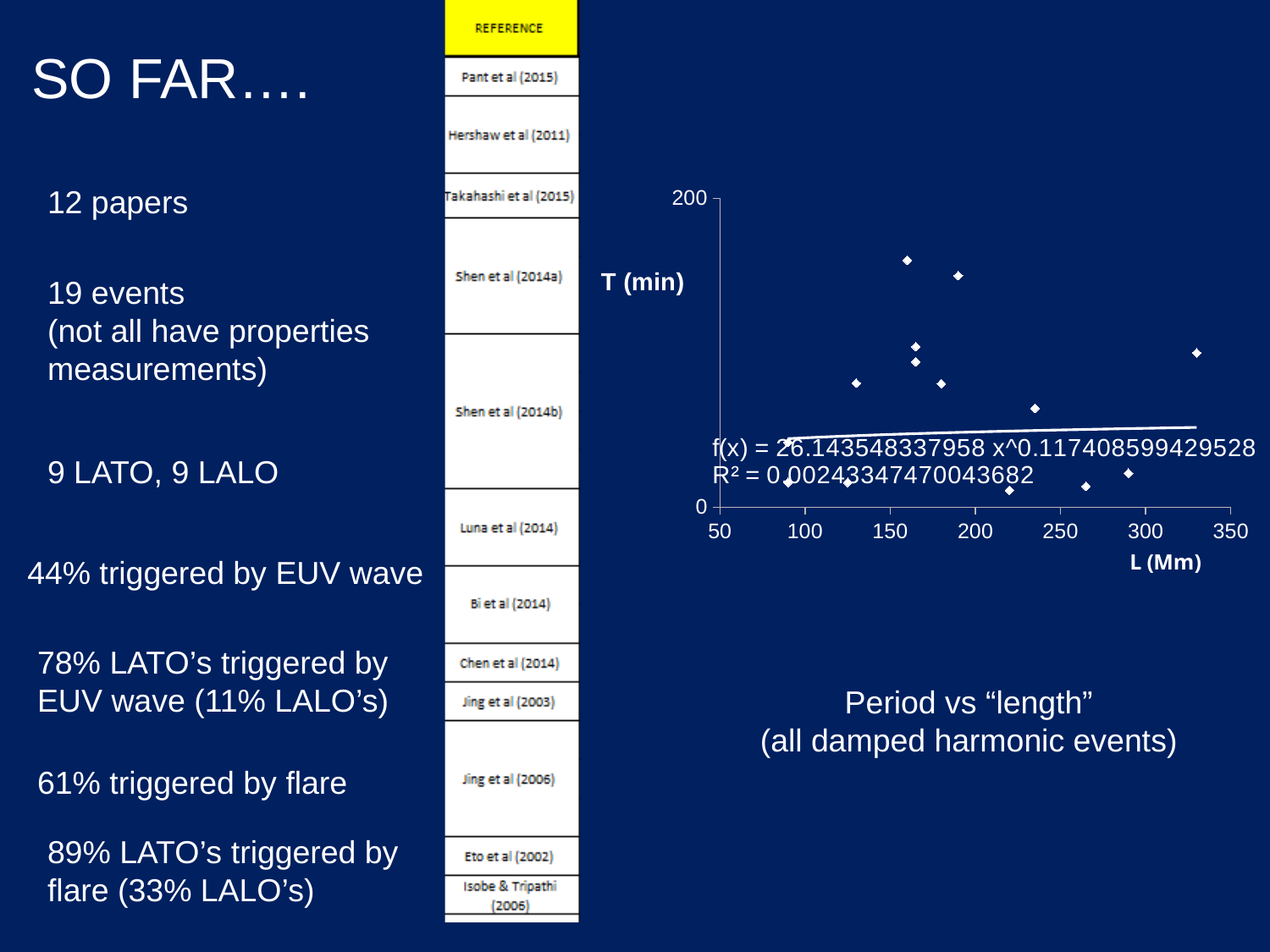
What is the R² value printed on the scatter chart? R² = 0.00243347470043682 What is the label of the x axis of the scatter chart? L (Mm) What kind of chart is shown on the slide? scatter chart What is the highest tick value shown on the x axis of the scatter chart? 350 What is the fitted equation printed on the scatter chart? f(x) = 26.143548337958 x^0.117408599429528 Is the T value of the highest point on the scatter chart greater or less than 100? greater What is the label of the y axis of the scatter chart? T (min) Does the fitted trendline on the scatter chart rise or fall as L increases? rises What is the highest tick value shown on the y axis of the scatter chart? 200 Are any points on the scatter chart plotted above T = 200? No Is the T value of the point at roughly L = 330 Mm greater or less than 50? greater